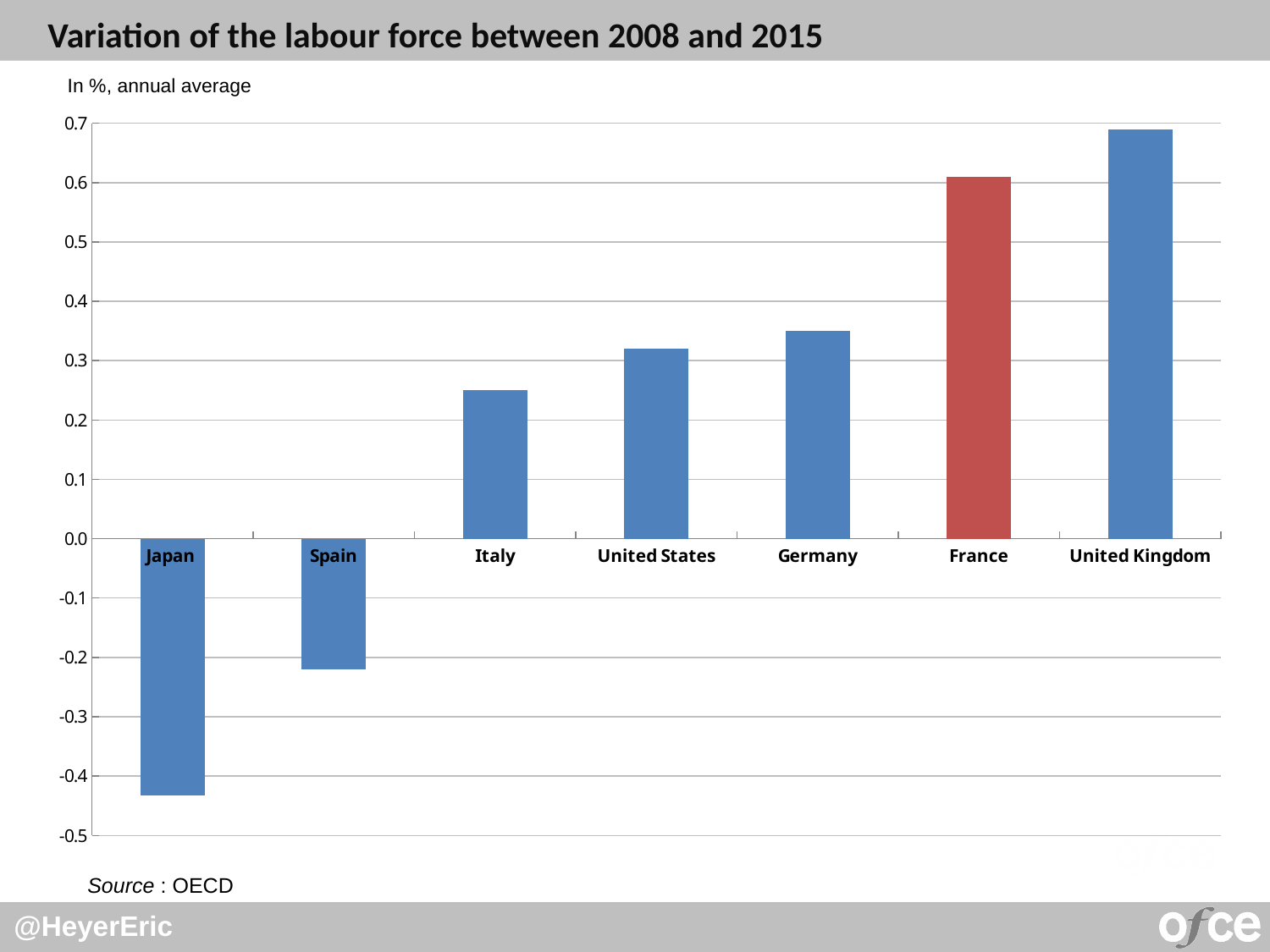
Which is larger, the value for France or the value for Germany? France Is the value for France greater or less than 0.5? greater Do the values rise or fall from left to right along the x axis? rise Which country has the highest variation of the labour force? United Kingdom Which country has the lowest variation of the labour force? Japan Is the value for Italy greater or less than 0.2? greater Is the value for Japan greater or less than -0.3? less What kind of chart is shown on the slide? bar chart How many countries are shown on the chart? 7